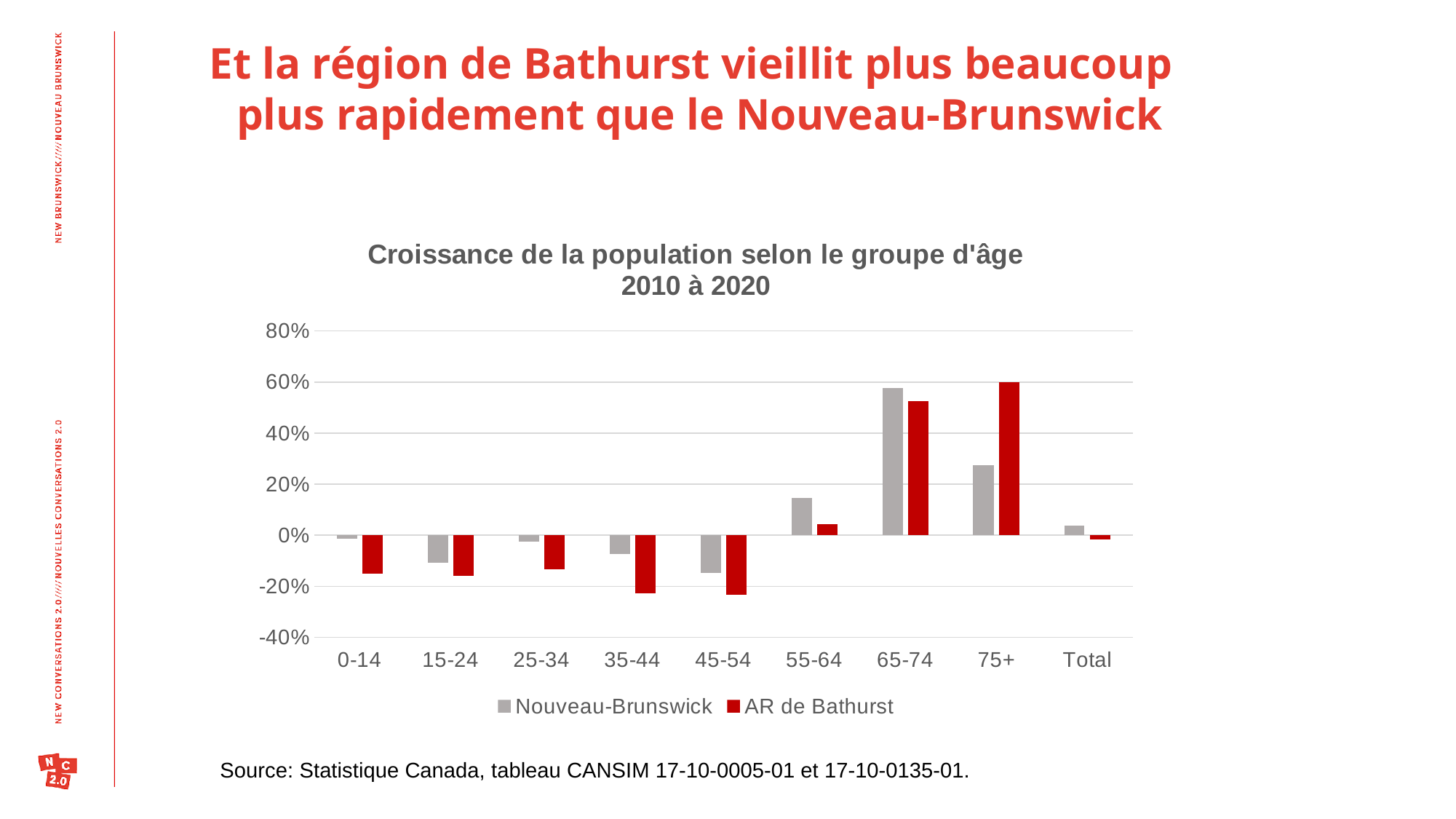
Is the Nouveau-Brunswick value for 55-64 greater or less than 20%? less For which category is the Nouveau-Brunswick bar the lowest? 45-54 In the 75+ category, which series has the larger value, Nouveau-Brunswick or AR de Bathurst? AR de Bathurst For which category is the Nouveau-Brunswick bar the highest? 65-74 What colour are the AR de Bathurst bars? red In the 65-74 category, which series has the larger value, Nouveau-Brunswick or AR de Bathurst? Nouveau-Brunswick Is the AR de Bathurst value for 75+ greater or less than 40%? greater How many series does the legend list? 2 How many age-group categories are shown on the x axis, including Total? 9 What kind of chart is shown on the slide? bar chart For which category is the AR de Bathurst bar the highest? 75+ Is the AR de Bathurst value for 45-54 greater or less than -20%? less